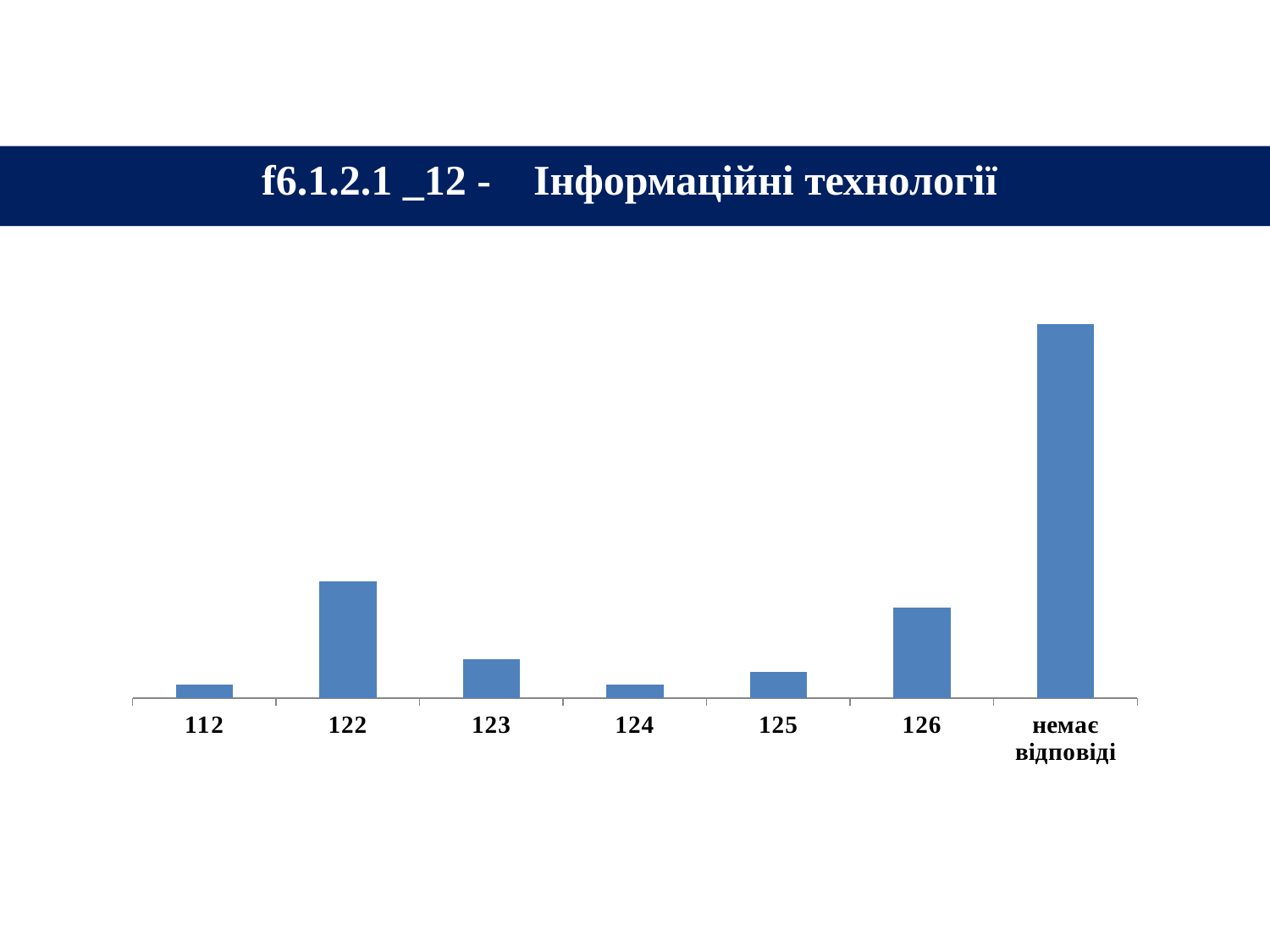
Which is larger, the value for 112 or the value for 122? 122 How many categories are shown on the x axis of the chart? 7 Which is larger, the value for 122 or the value for 126? 122 Which is larger, the value for 126 or the value for немає відповіді? немає відповіді What colour are the bars in the chart? blue Which category has the highest bar in the chart? немає відповіді What is the title shown above the chart? f6.1.2.1 _12 - Інформаційні технології What kind of chart is shown on the slide? bar chart